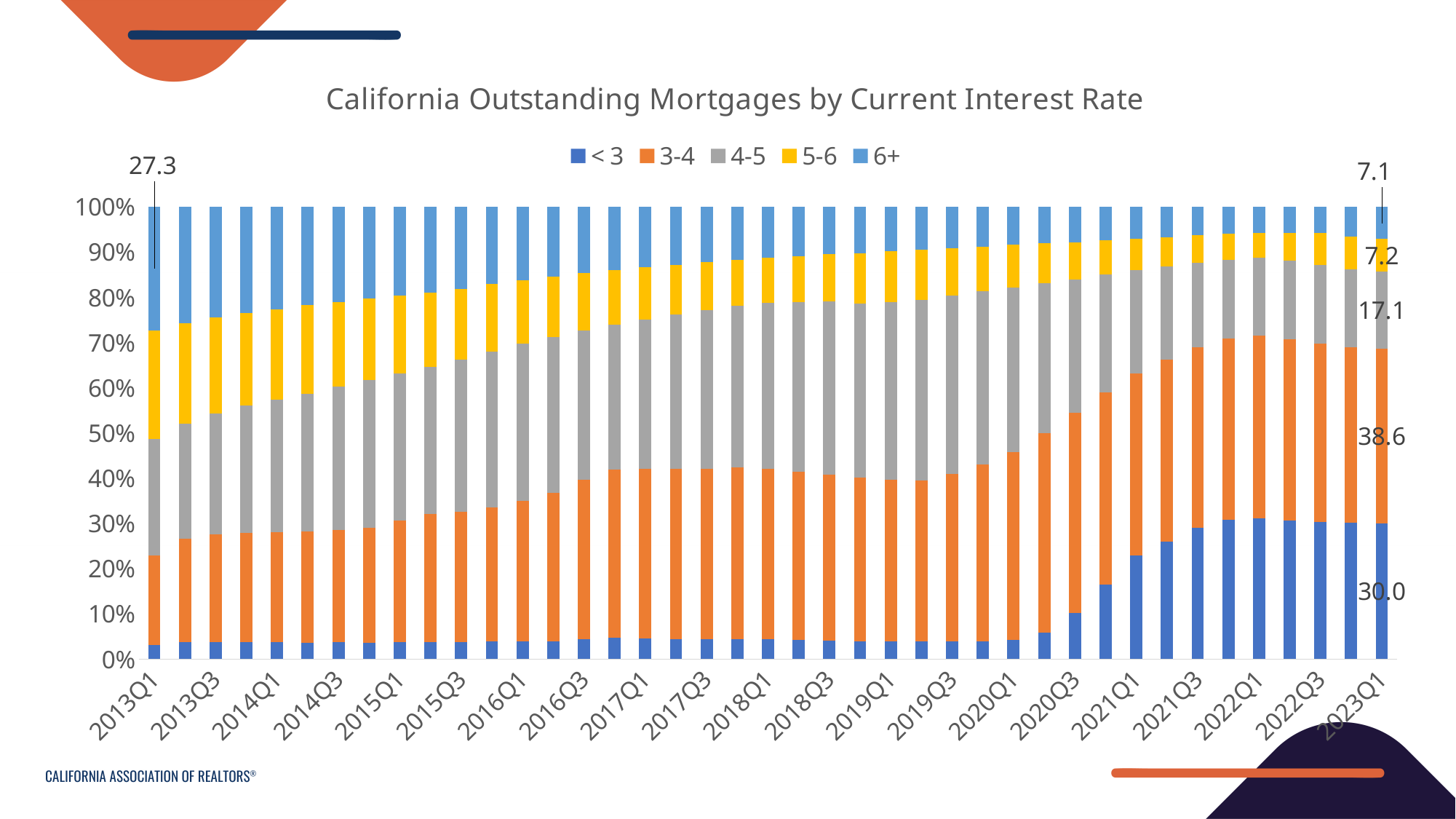
By how much did the 6+ value fall from 2013Q1 to 2023Q1? 20.2 How many series does the legend list? 5 What is the value for the 4-5 series in 2023Q1? 17.1 What is the value for the 6+ series in 2013Q1? 27.3 What kind of chart is shown on the slide? Stacked bar chart Does the share of the < 3 series rise or fall from 2013Q1 to 2023Q1? Rise What is the difference between the 3-4 and < 3 values in 2023Q1? 8.6 Which series has the largest share in 2023Q1? 3-4 What is the value for the 6+ series in 2023Q1? 7.1 What is the value for the 5-6 series in 2023Q1? 7.2 What is the value for the 3-4 series in 2023Q1? 38.6 What is the value for the < 3 series in 2023Q1? 30.0